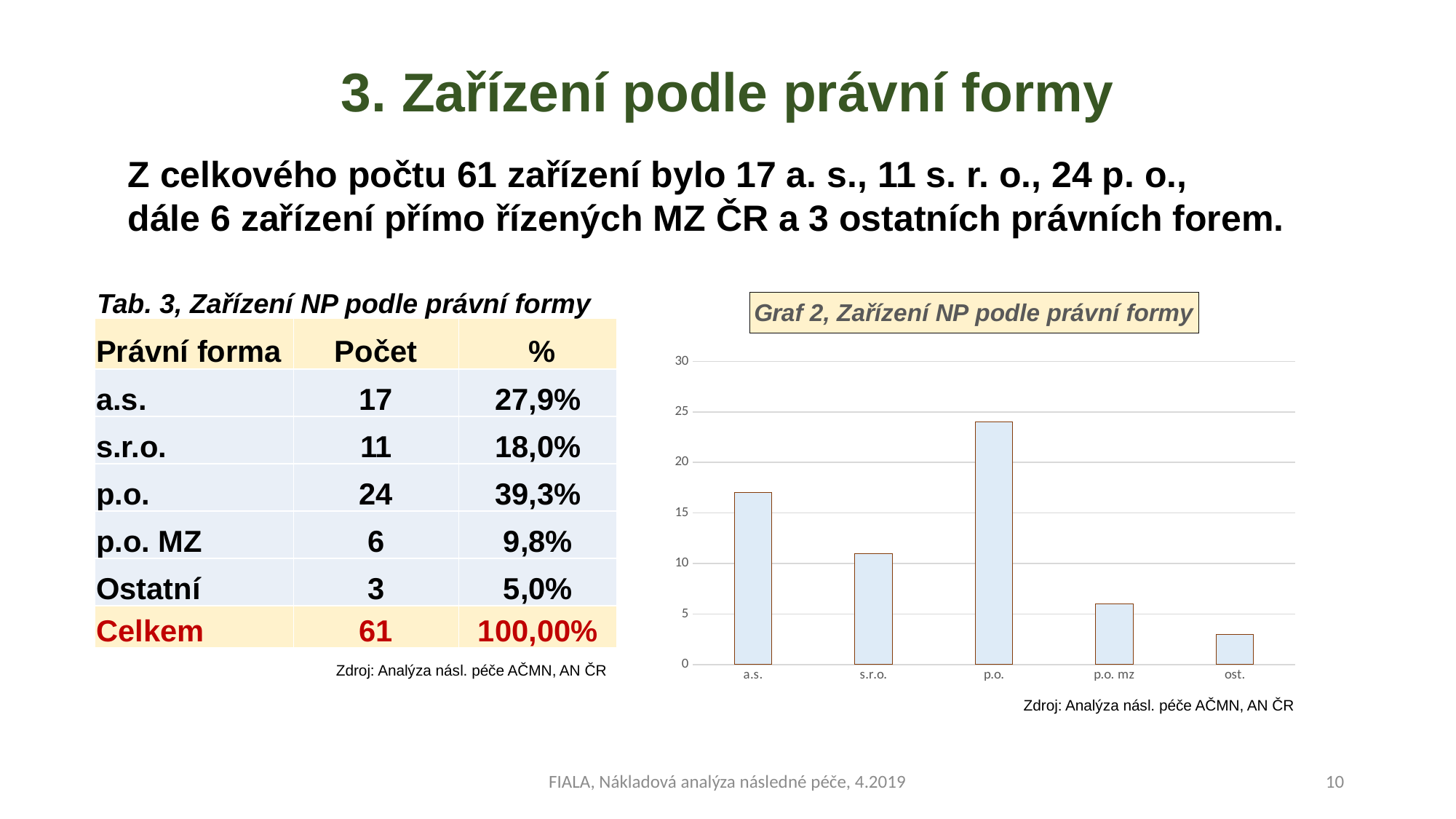
In the chart Graf 2, which bar is taller, a.s. or s.r.o.? a.s. In the chart Graf 2, which bar is taller, p.o. mz or ost.? p.o. mz What is the title of the chart on the right side of the slide? Graf 2, Zařízení NP podle právní formy What is the value plotted for s.r.o. in the chart Graf 2, as given in the table on the slide? 11 In the chart Graf 2, is the bar for a.s. greater or less than 15? greater In the chart Graf 2, which category has the lowest bar? ost. In the chart Graf 2, is the bar for p.o. mz greater or less than 10? less What is the value plotted for p.o. in the chart Graf 2, as given in the table on the slide? 24 How many categories are shown on the x axis of the chart Graf 2? 5 In the chart Graf 2, which category has the highest bar? p.o. What kind of chart is Graf 2, Zařízení NP podle právní formy? bar chart In the chart Graf 2, is the bar for p.o. greater or less than 20? greater